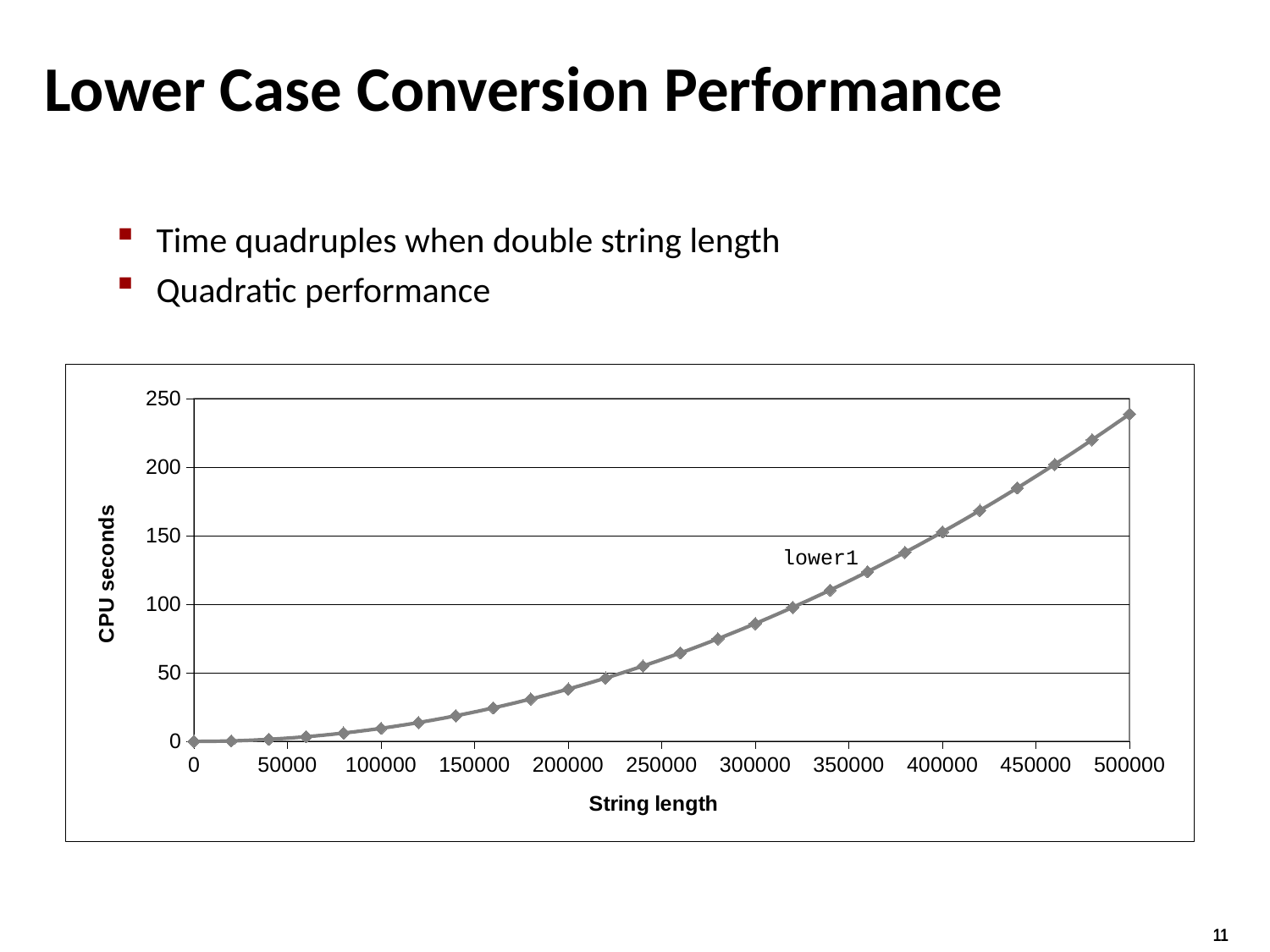
What is the title of the y axis? CPU seconds What is the label of the data series plotted on the chart? lower1 At which string length is the CPU seconds value lowest? 0 Which string length has the larger CPU seconds value, 300000 or 400000? 400000 Is the CPU seconds value at string length 300000 greater or less than 100? less At which string length is the CPU seconds value highest? 500000 Is the CPU seconds value at string length 200000 greater or less than 50? less Is the CPU seconds value at string length 500000 greater or less than 200? greater What kind of chart is shown on the slide? line chart Do the CPU seconds rise or fall as string length increases? rise How many series are plotted on the chart? 1